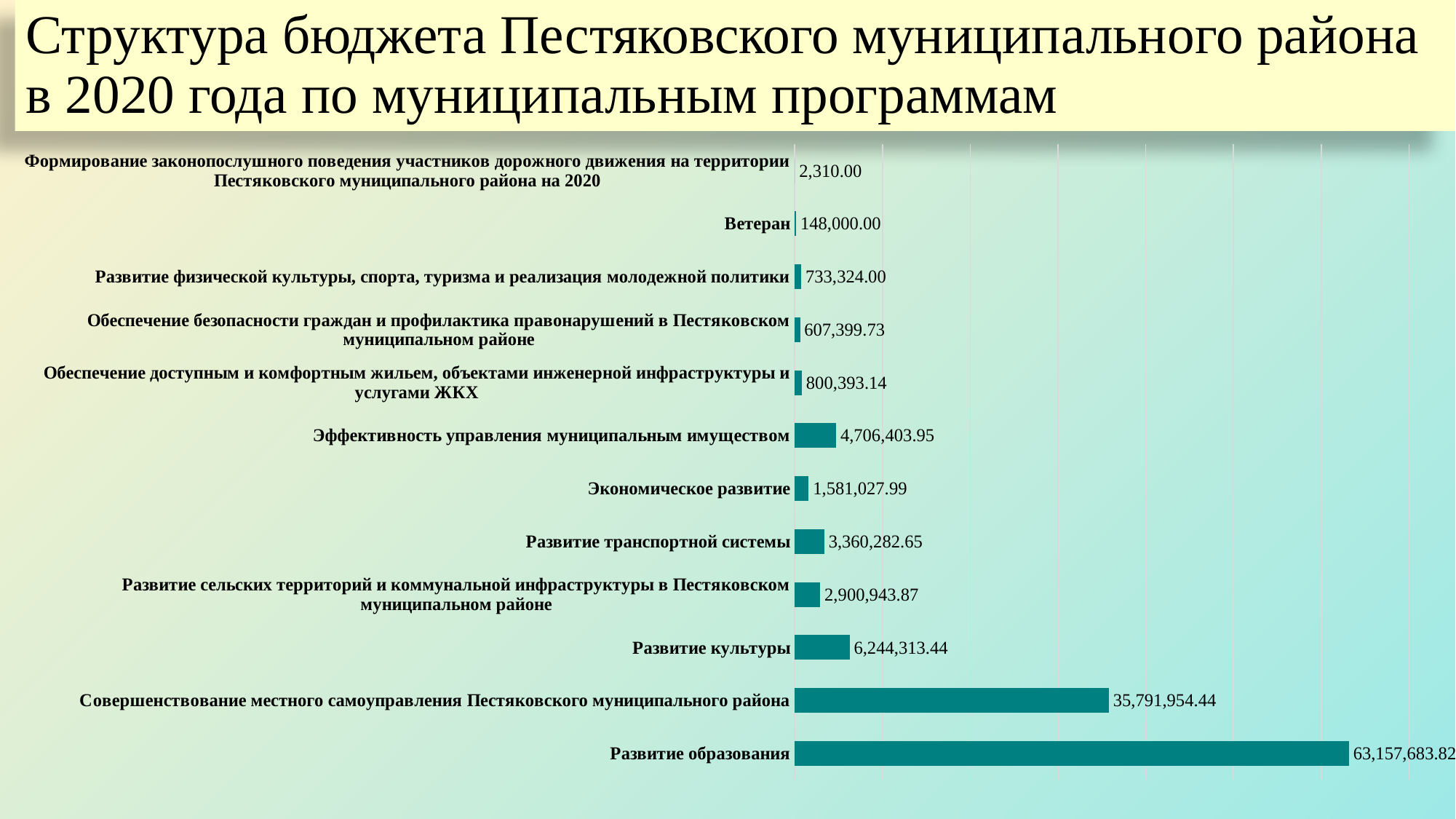
How many municipal programs (categories) are shown in the chart? 12 Which is larger: the value for Развитие транспортной системы or the value for Развитие сельских территорий и коммунальной инфраструктуры в Пестяковском муниципальном районе? Развитие транспортной системы What type of chart is shown on the slide? Bar chart Which program has the lowest value in the chart? Формирование законопослушного поведения участников дорожного движения на территории Пестяковского муниципального района на 2020 What is the value for Ветеран? 148,000.00 Which program has the highest value in the chart? Развитие образования What is the title of the slide containing the chart? Структура бюджета Пестяковского муниципального района в 2020 года по муниципальным программам What is the value for Развитие образования? 63,157,683.82 What is the value for Экономическое развитие? 1,581,027.99 What is the difference between the values for Развитие культуры and Эффективность управления муниципальным имуществом? 1,537,909.49 What is the value for Развитие культуры? 6,244,313.44 What is the difference between the values for Развитие образования and Совершенствование местного самоуправления Пестяковского муниципального района? 27,365,729.38